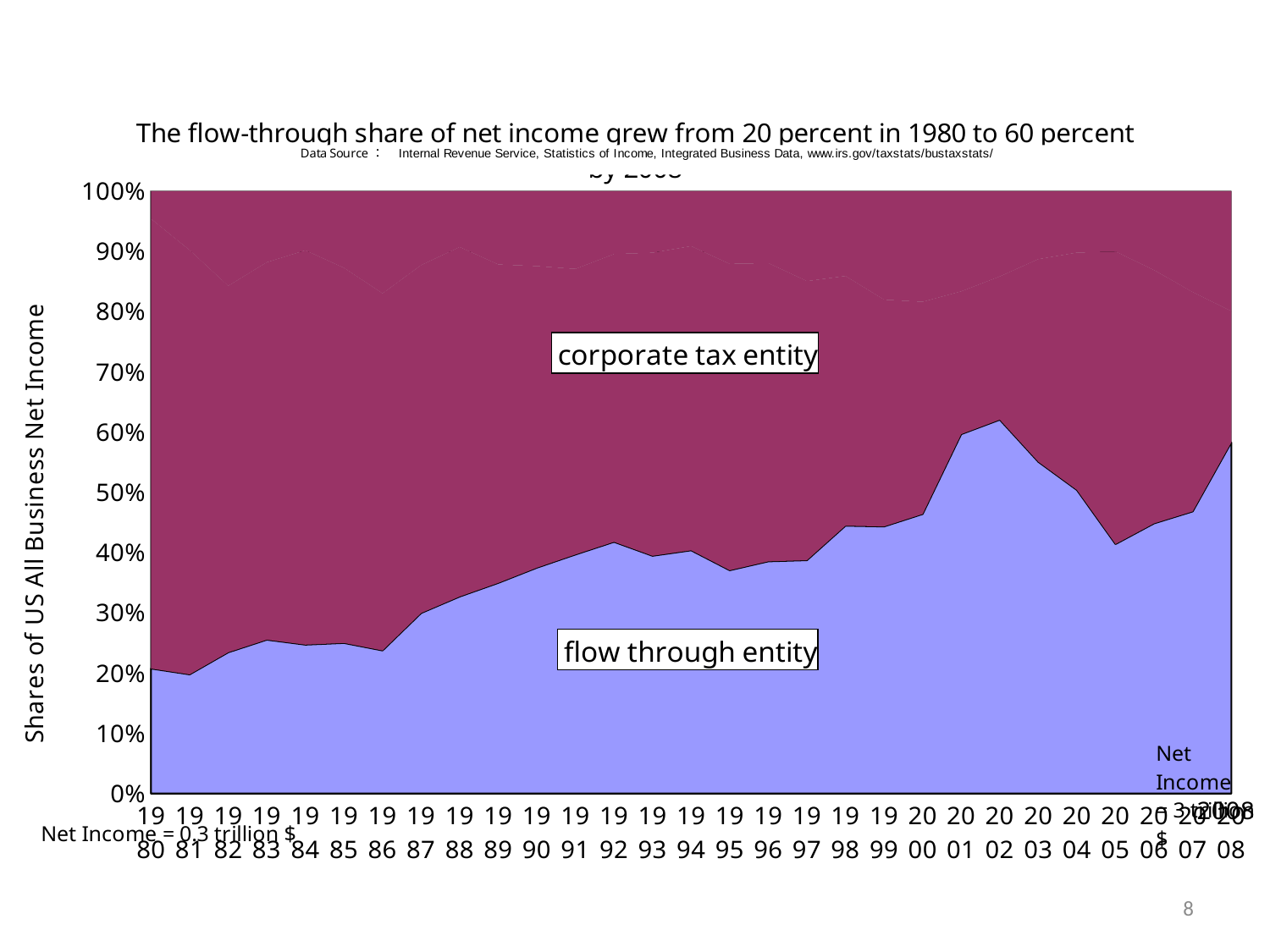
How many years are plotted along the x axis? 29 What is the label on the vertical axis? Shares of US All Business Net Income Is the flow through entity share in 2005 greater or less than 50%? less Is the flow through entity share in 2002 greater or less than 50%? greater Is the flow through entity share in 1980 greater or less than 30%? less In 1980, which series has the larger share: flow through entity or corporate tax entity? corporate tax entity What kind of chart is shown on the slide? Area chart Which series is shown in the blue area at the bottom of the chart? flow through entity How many series are plotted in the chart? 3 Which year has the highest flow through entity share? 2002 Does the flow through entity share generally rise or fall from 1980 to 2008? rise